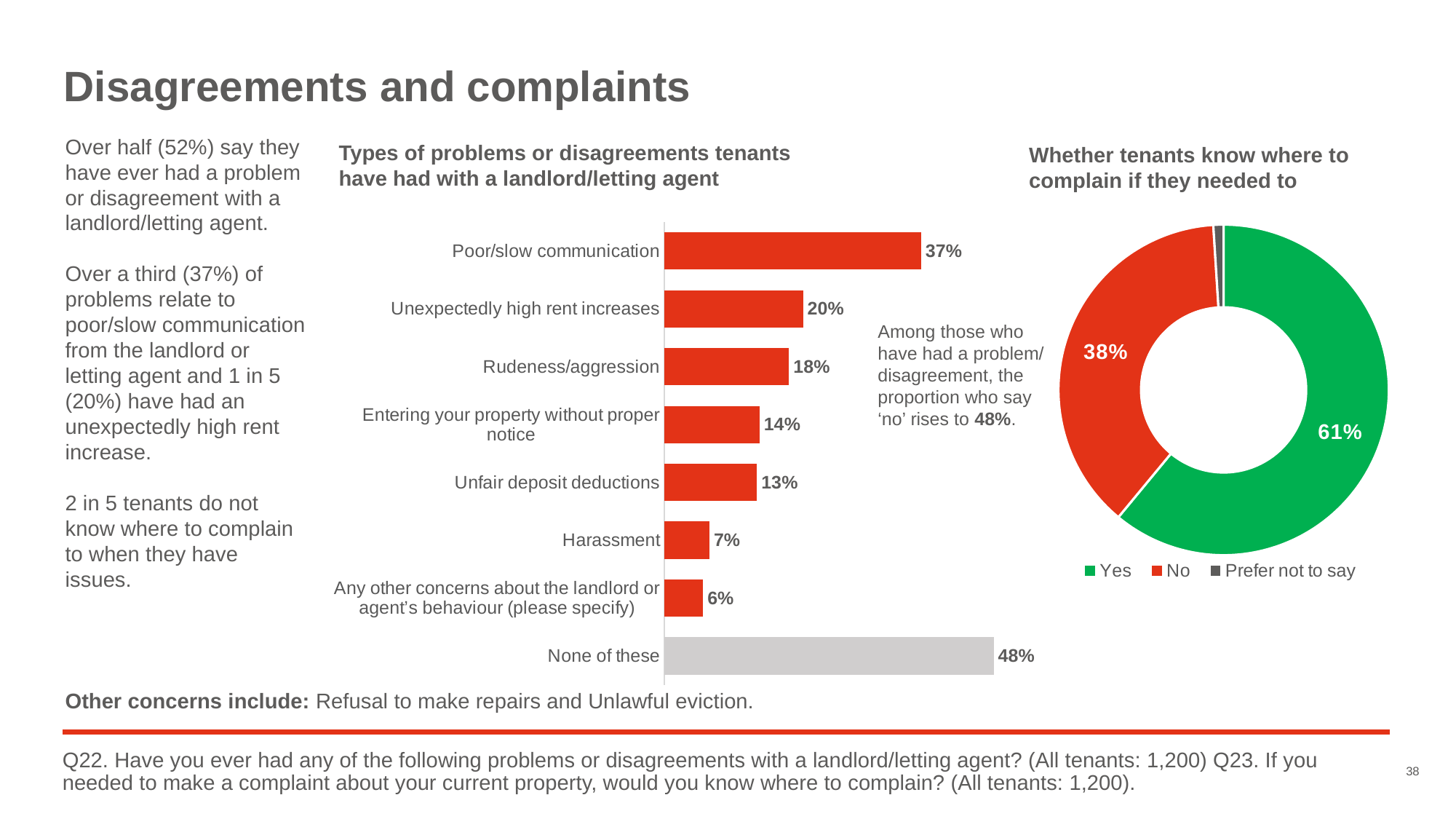
In the 'Types of problems or disagreements tenants have had with a landlord/letting agent' chart, what is the value for Poor/slow communication? 37% In the 'Whether tenants know where to complain if they needed to' chart, what is the value for No? 38% In the 'Types of problems or disagreements' bar chart, which category has the highest value? None of these In the 'Types of problems or disagreements' bar chart, what is the value for Unfair deposit deductions? 13% In the 'Types of problems or disagreements' bar chart, what is the difference between Unexpectedly high rent increases and Rudeness/aggression? 2% In the 'Whether tenants know where to complain if they needed to' chart, what share of tenants answered Yes? 61% In the 'Types of problems or disagreements' bar chart, what is the value for None of these? 48% How many categories are shown in the 'Types of problems or disagreements' bar chart? 8 What kind of chart is the 'Types of problems or disagreements tenants have had with a landlord/letting agent' chart? Bar chart In the 'Types of problems or disagreements' bar chart, which is larger: Entering your property without proper notice or Harassment? Entering your property without proper notice In the 'Types of problems or disagreements' bar chart, which category has the lowest value? Any other concerns about the landlord or agent's behaviour (please specify) How many entries does the legend of the 'Whether tenants know where to complain if they needed to' chart list? 3